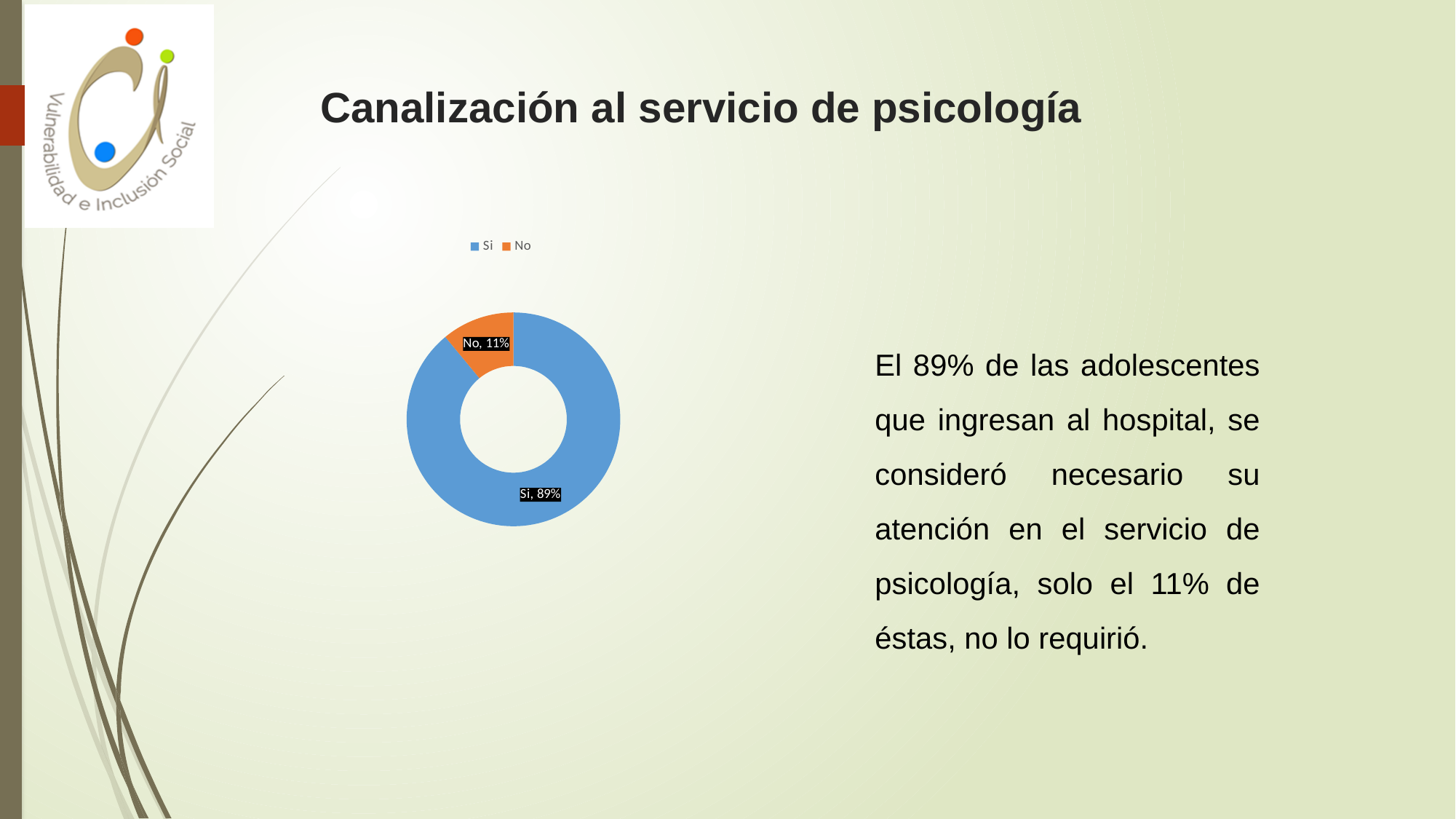
What share of the chart does the 'No' slice take up? 11% Which category has the largest share of the chart? Si How many categories are shown in the chart? 2 What kind of chart is shown on the slide? Doughnut (pie) chart What percentage does the 'Si' slice represent? 89% What is the difference in percentage points between the 'Si' and 'No' slices? 78 How many entries does the legend list? 2 What is the title of the slide containing the chart? Canalización al servicio de psicología Which category has the smallest share of the chart? No Which is larger, the 'Si' slice or the 'No' slice? Si What percentage does the 'No' slice represent? 11% What colour is the 'Si' slice? Blue